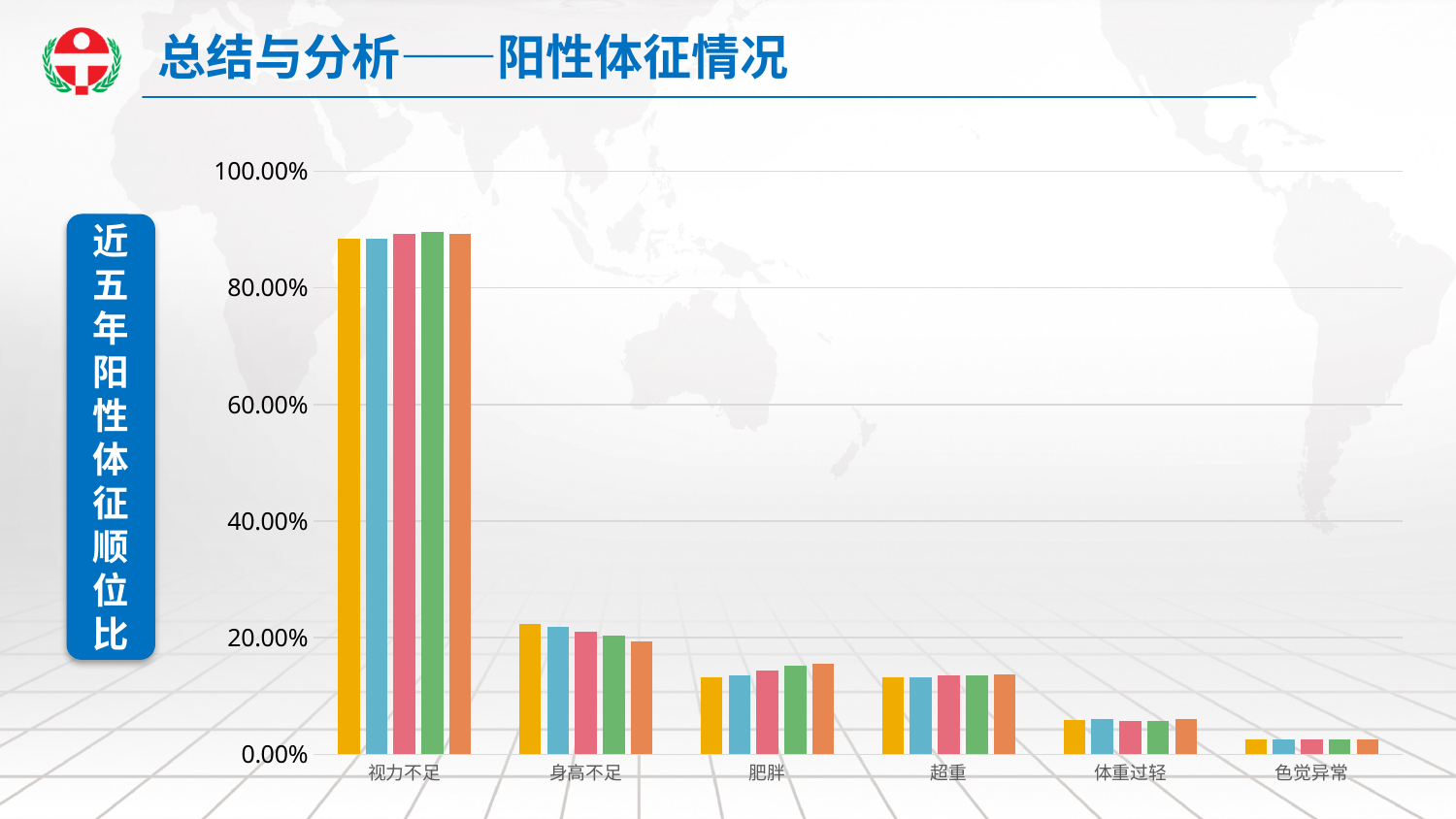
Are the values for 色觉异常 greater or less than 20.00%? less Are the values for 肥胖 greater or less than 20.00%? less Which category has larger values, 体重过轻 or 色觉异常? 体重过轻 How many categories are shown on the x axis of the chart? 6 Which category has the lowest values in the chart? 色觉异常 Are the values for 视力不足 greater or less than 80.00%? greater Within the 身高不足 group, do the bars rise or fall from left to right? fall What is the highest tick label shown on the y axis of the chart? 100.00% What kind of chart is shown on the slide? bar chart Which category has the highest values in the chart? 视力不足 Which category has larger values, 身高不足 or 肥胖? 身高不足 How many bars are plotted for each category in the chart? 5